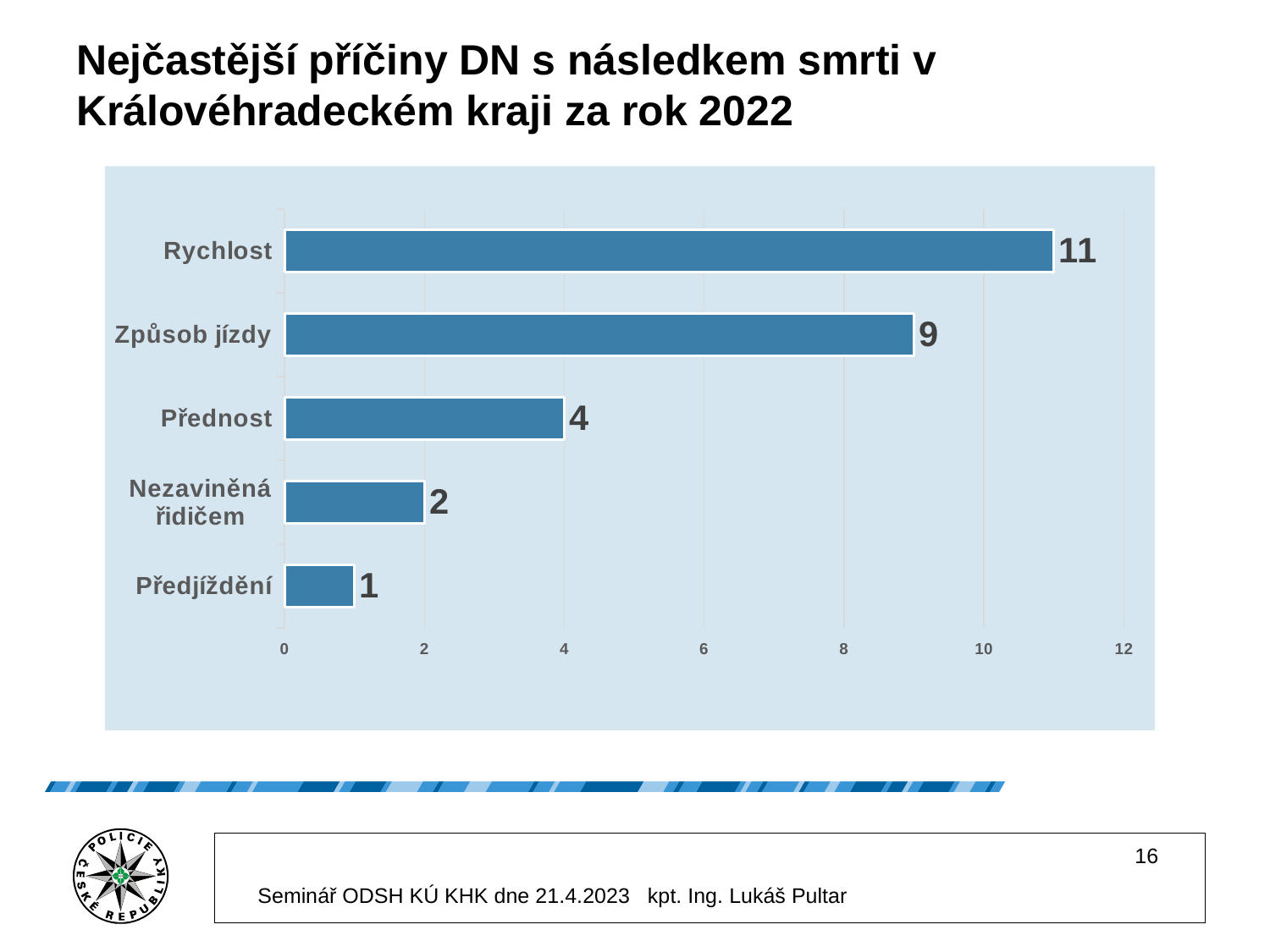
What kind of chart is shown on the slide? bar chart What is the value for Nezaviněná řidičem? 2 Which category has the highest value? Rychlost What is the value for Přednost? 4 What is the value for Předjíždění? 1 What is the value for Způsob jízdy? 9 What is the value for Rychlost? 11 How many categories are shown in the chart? 5 Which category has the lowest value? Předjíždění What is the title of the slide containing the chart? Nejčastější příčiny DN s následkem smrti v Královéhradeckém kraji za rok 2022 What is the difference between the values for Rychlost and Způsob jízdy? 2 Which is larger, the value for Přednost or the value for Nezaviněná řidičem? Přednost